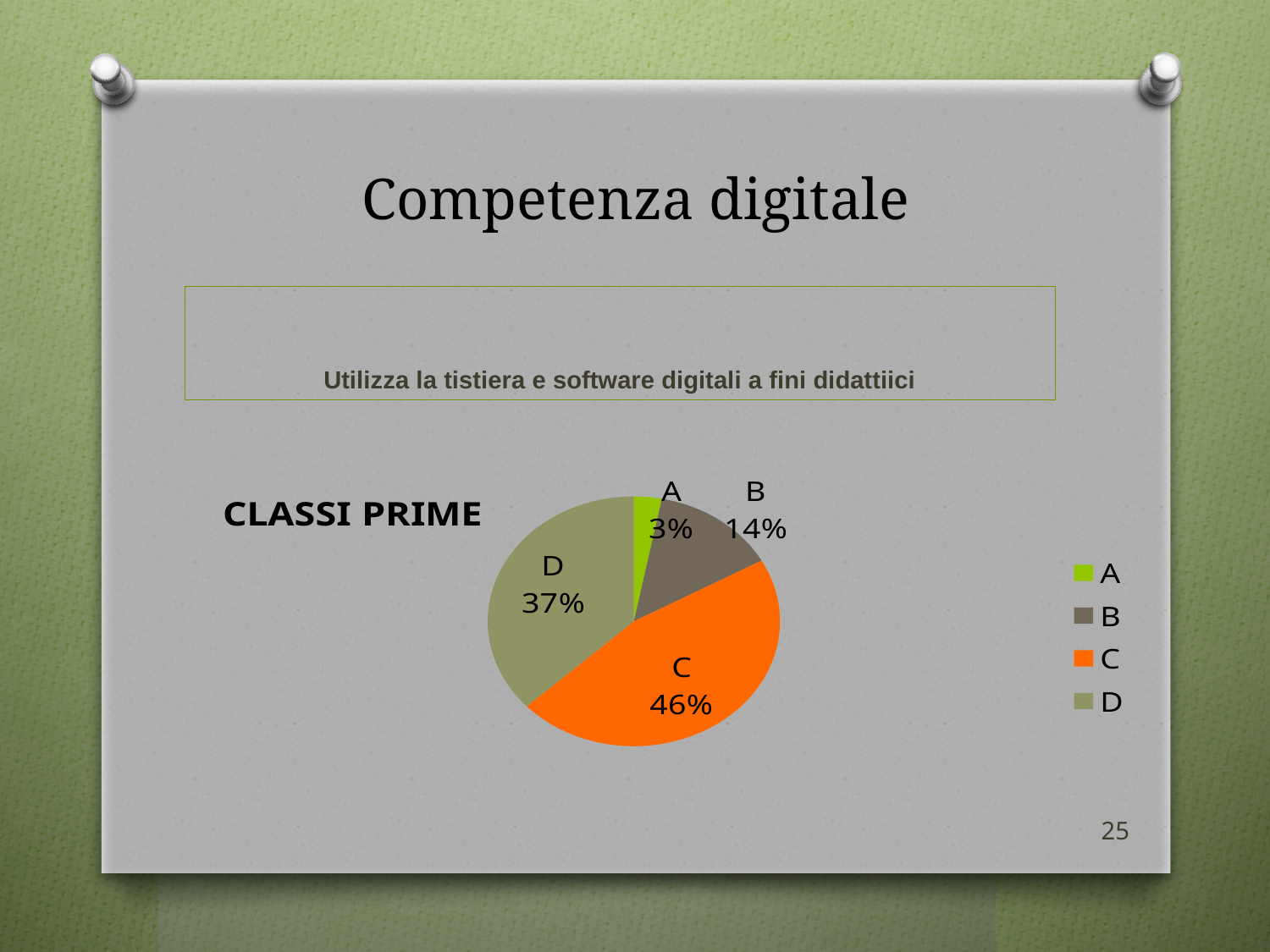
How many entries does the legend list? 4 How many slices does the pie chart have? 4 What is the value shown for slice A? 3% Which slice is the largest? C Which slice is the smallest? A What kind of chart is shown on the slide? pie chart What is the difference between the values for B and A? 11% What share of the pie does slice C represent? 46% What is the value shown for slice B? 14% What is the difference between the values for C and D? 9% What share of the pie does slice D represent? 37% Which is larger, the value for B or the value for D? D